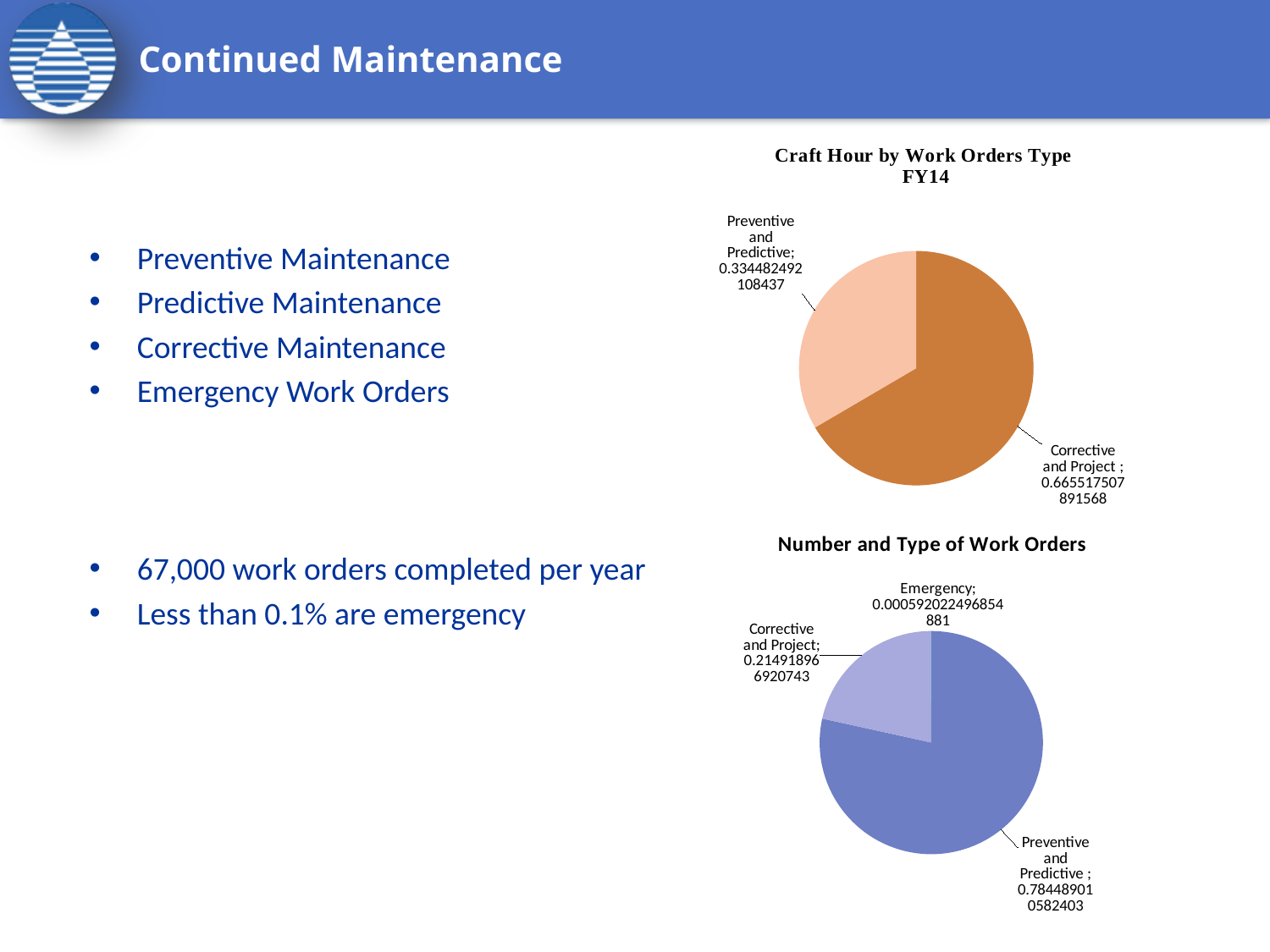
In the 'Craft Hour by Work Orders Type FY14' chart, which category has the largest slice? Corrective and Project In the 'Craft Hour by Work Orders Type FY14' chart, what value is shown for Corrective and Project? 0.665517507891568 In the 'Number and Type of Work Orders' chart, how many categories are shown? 3 In the 'Craft Hour by Work Orders Type FY14' chart, how many slices does the pie have? 2 What kind of chart is 'Craft Hour by Work Orders Type FY14'? Pie chart In the 'Number and Type of Work Orders' chart, what value is shown for Preventive and Predictive? 0.784489010582403 In the 'Craft Hour by Work Orders Type FY14' chart, what value is shown for Preventive and Predictive? 0.334482492108437 In the 'Number and Type of Work Orders' chart, which is larger: Corrective and Project or Preventive and Predictive? Preventive and Predictive In the 'Number and Type of Work Orders' chart, which category has the largest slice? Preventive and Predictive In the 'Number and Type of Work Orders' chart, which category has the smallest slice? Emergency In the 'Number and Type of Work Orders' chart, what value is shown for Emergency? 0.000592022496854881 In the 'Number and Type of Work Orders' chart, what value is shown for Corrective and Project? 0.214918966920743